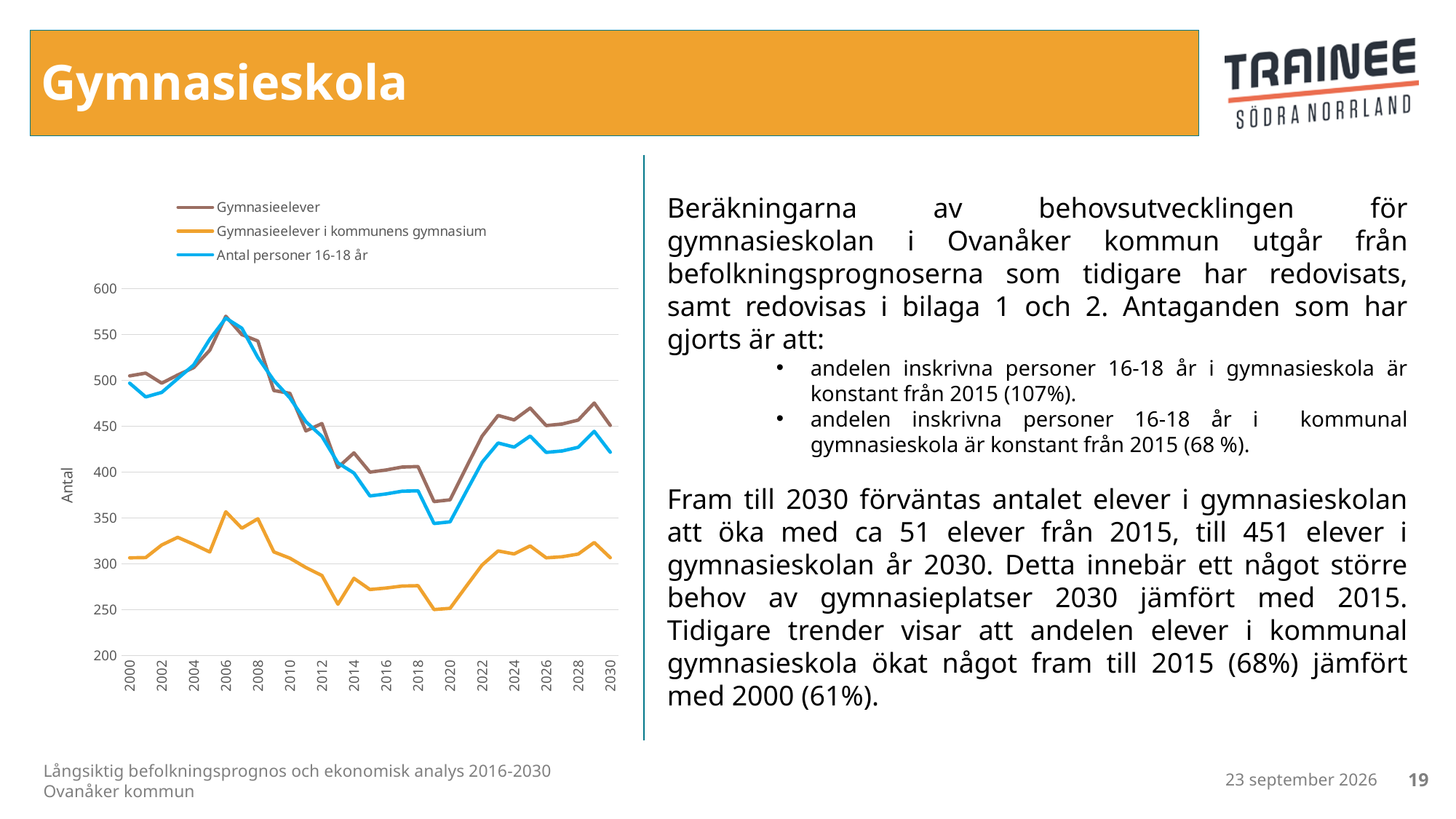
Is the value for Gymnasieelever in 2006 greater or less than 550? greater Which series has the lowest values across the whole period? Gymnasieelever i kommunens gymnasium Which series is shown in blue in the chart? Antal personer 16-18 år What kind of chart is shown on the slide? Line chart In 2016, which is larger: Gymnasieelever or Antal personer 16-18 år? Gymnasieelever In which year does the Gymnasieelever i kommunens gymnasium series reach its highest value? 2006 What is the label on the vertical axis of the chart? Antal Is the value for Gymnasieelever i kommunens gymnasium in 2019 greater or less than 300? less Does the Gymnasieelever series rise or fall between 2006 and 2013? Fall Is the value for Antal personer 16-18 år in 2019 greater or less than 400? less How many series does the chart legend list? 3